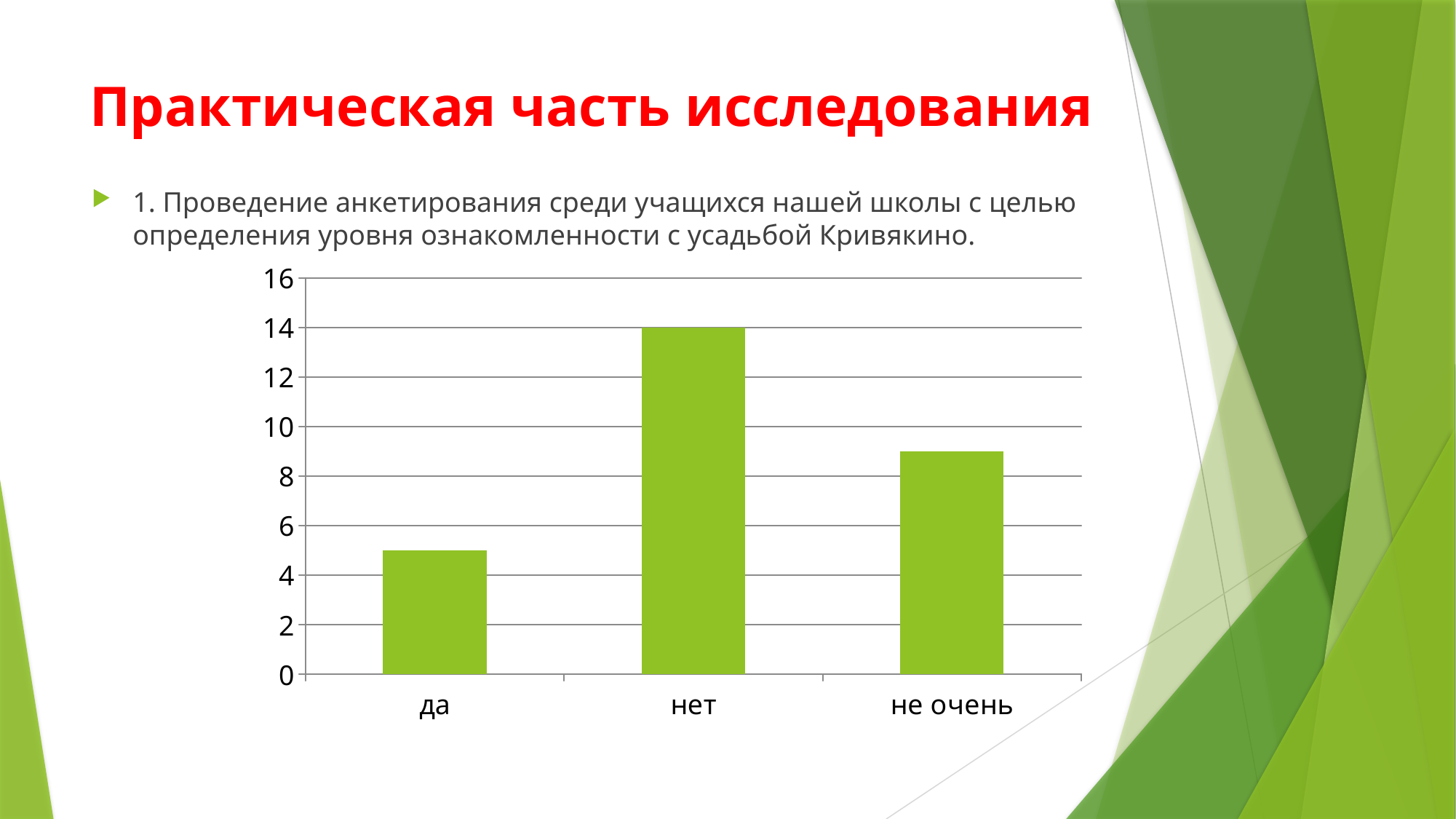
Which category has the highest value? нет Which category has the lowest value? да Is the value for "не очень" greater or less than 8? greater Is the value for "не очень" greater or less than 10? less Which is larger, the value for "да" or the value for "не очень"? не очень What colour are the bars in the chart? green What is the value for the category "нет"? 14 What kind of chart is shown on the slide? bar chart Is the value for "да" greater or less than 4? greater How many categories are shown on the x axis of the chart? 3 Which is larger, the value for "нет" or the value for "не очень"? нет